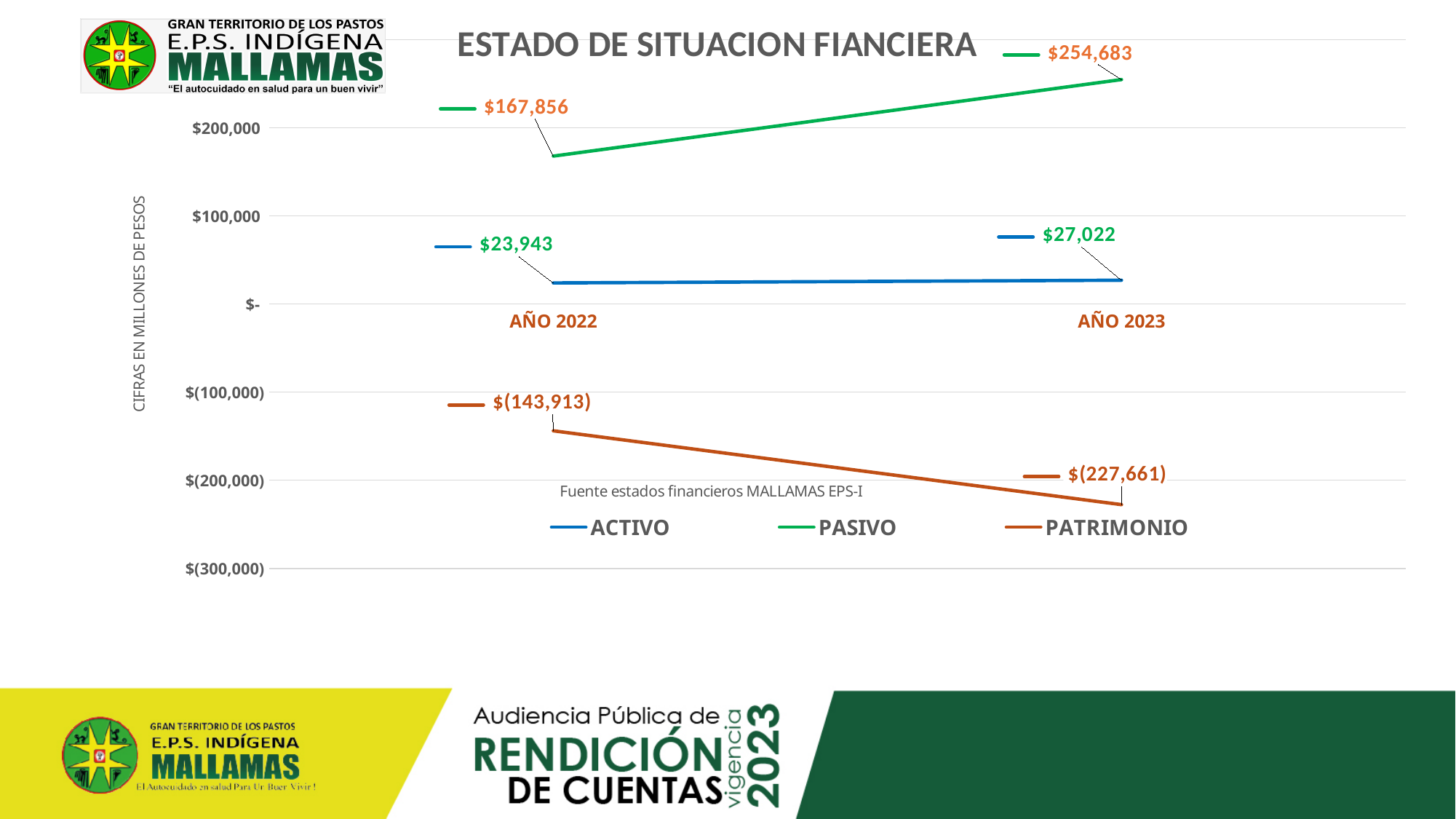
What is the value of PASIVO for AÑO 2023? $254,683 What is the value of PASIVO for AÑO 2022? $167,856 Does the PATRIMONIO line rise or fall from AÑO 2022 to AÑO 2023? Fall What is the difference between ACTIVO in AÑO 2023 and ACTIVO in AÑO 2022? $3,079 What is the value of ACTIVO for AÑO 2022? $23,943 By how much did PASIVO increase from AÑO 2022 to AÑO 2023? $86,827 What is the value of PATRIMONIO for AÑO 2023? $(227,661) Which series has the highest value in AÑO 2023? PASIVO What kind of chart is shown on the slide? Line chart How many series does the legend list? 3 Which series has the lowest value in AÑO 2022? PATRIMONIO Which is larger: ACTIVO in AÑO 2022 or ACTIVO in AÑO 2023? ACTIVO in AÑO 2023